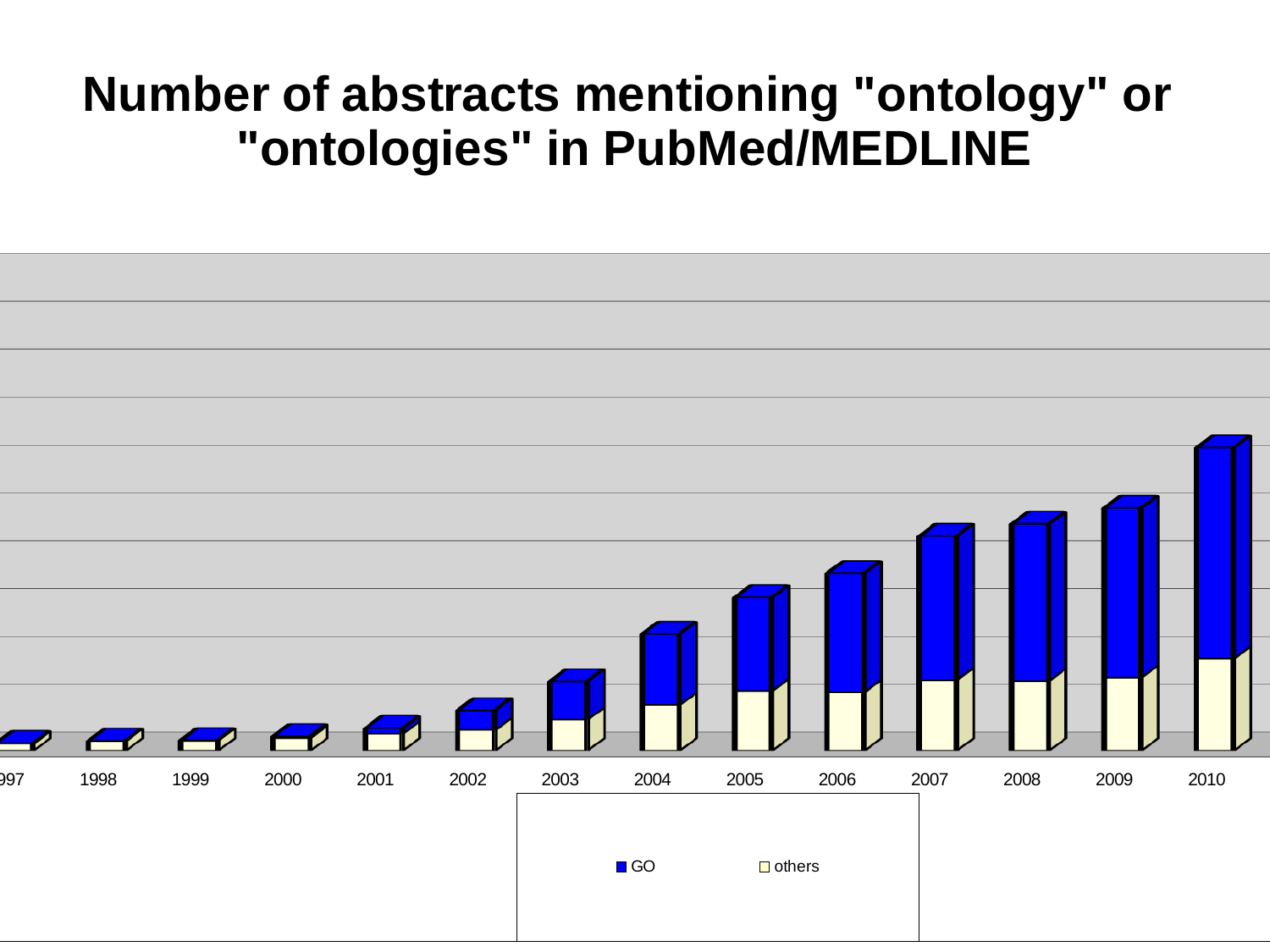
Which year has the tallest bar? 2010 Which bar is taller, 2002 or 2004? 2004 What are the two series named in the legend? GO and others Which bar is taller, 2005 or 2010? 2010 How many series does the legend list? 2 Which series is shown in blue? GO In 2010, which segment is larger, GO or others? GO How many years are shown along the x axis? 14 What kind of chart is shown on the slide? Stacked bar chart What is the last year shown on the x axis? 2010 Do the bar heights generally rise or fall from 1997 to 2010? Rise